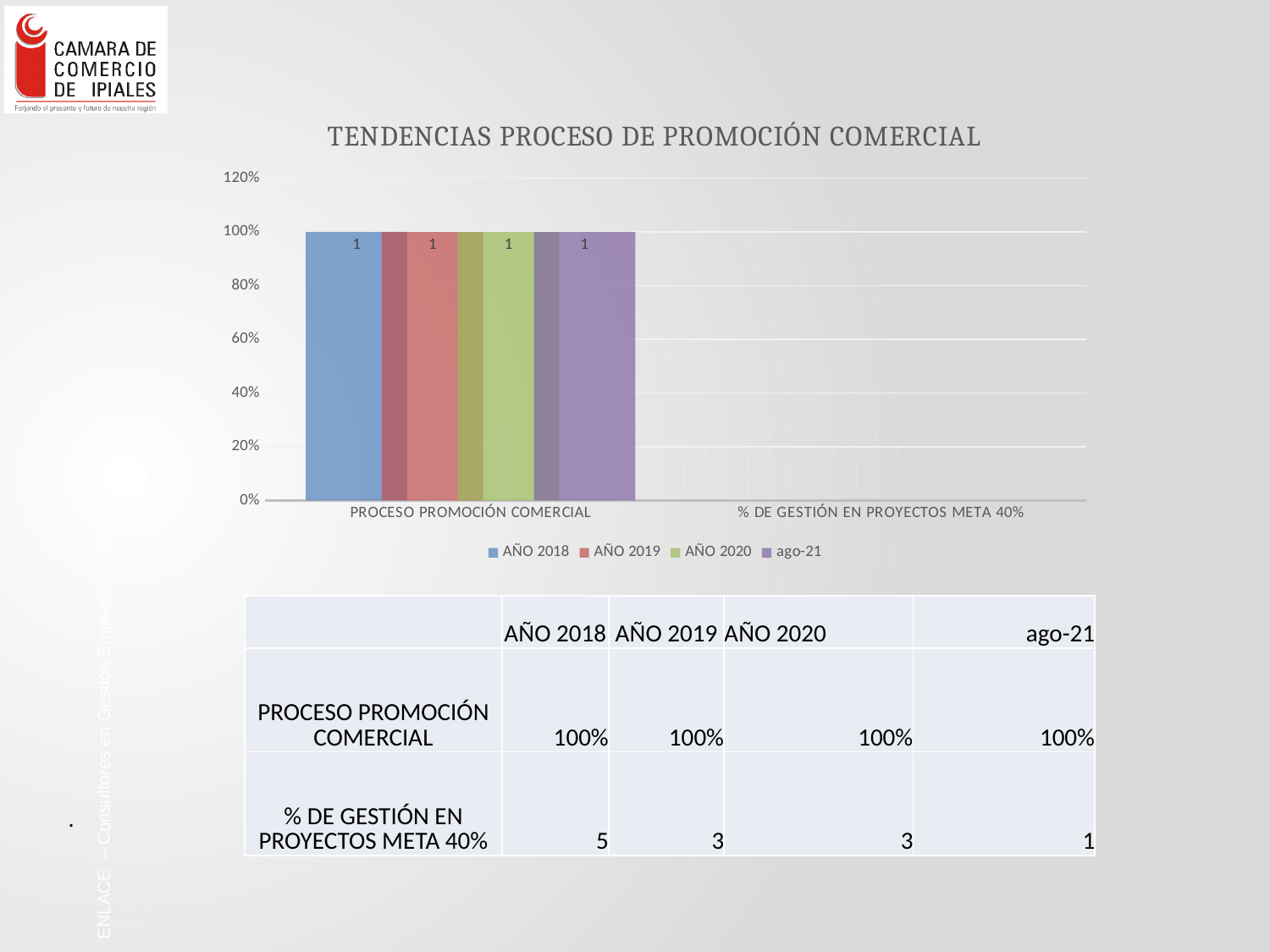
Which series is listed first in the chart legend? AÑO 2018 Is the ago-21 bar for PROCESO PROMOCIÓN COMERCIAL greater or less than 60%? greater What kind of chart is shown on the slide? bar chart What data label is printed on the AÑO 2018 bar for PROCESO PROMOCIÓN COMERCIAL? 1 How many categories are shown on the x axis of the chart? 2 Is the AÑO 2019 bar for PROCESO PROMOCIÓN COMERCIAL greater or less than 80%? greater How many series does the chart legend list? 4 What data label is printed on the AÑO 2020 bar for PROCESO PROMOCIÓN COMERCIAL? 1 What is the highest value shown on the y axis of the chart? 120% What is the label of the second category on the x axis? % DE GESTIÓN EN PROYECTOS META 40%